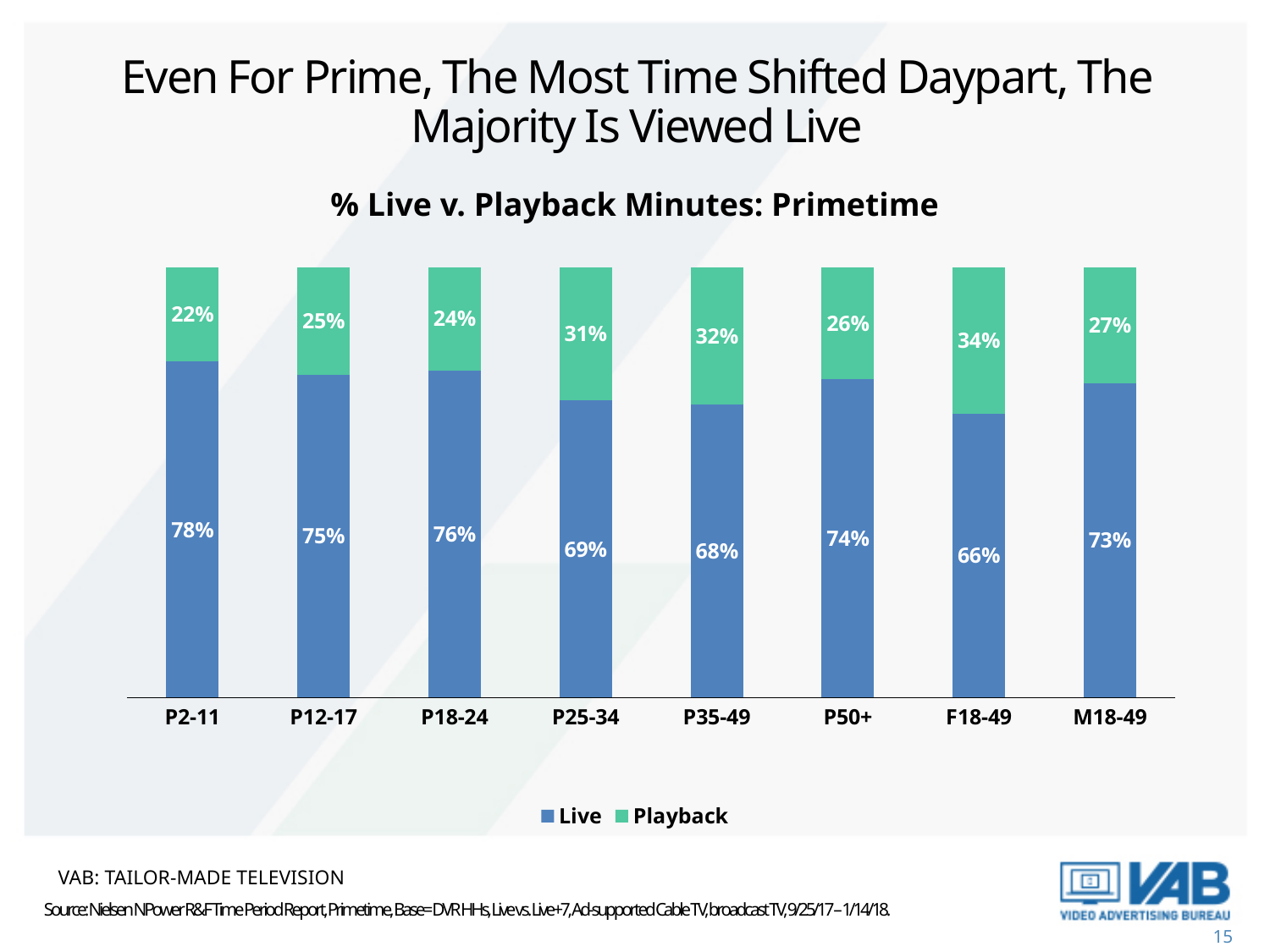
What is the title of the chart? % Live v. Playback Minutes: Primetime What is the Live value for M18-49? 73% Which category has the lowest Live value? F18-49 What is the difference between the Live value for P2-11 and the Live value for F18-49? 12% How many categories are shown on the x axis? 8 What is the Playback value for F18-49? 34% How many series does the legend list? 2 What kind of chart is shown on the slide? Stacked bar chart Which category has the highest Live value? P2-11 Is the Playback value for P25-34 larger than the Playback value for P50+? Yes Which category has the highest Playback value? F18-49 What is the Live value for P2-11? 78%